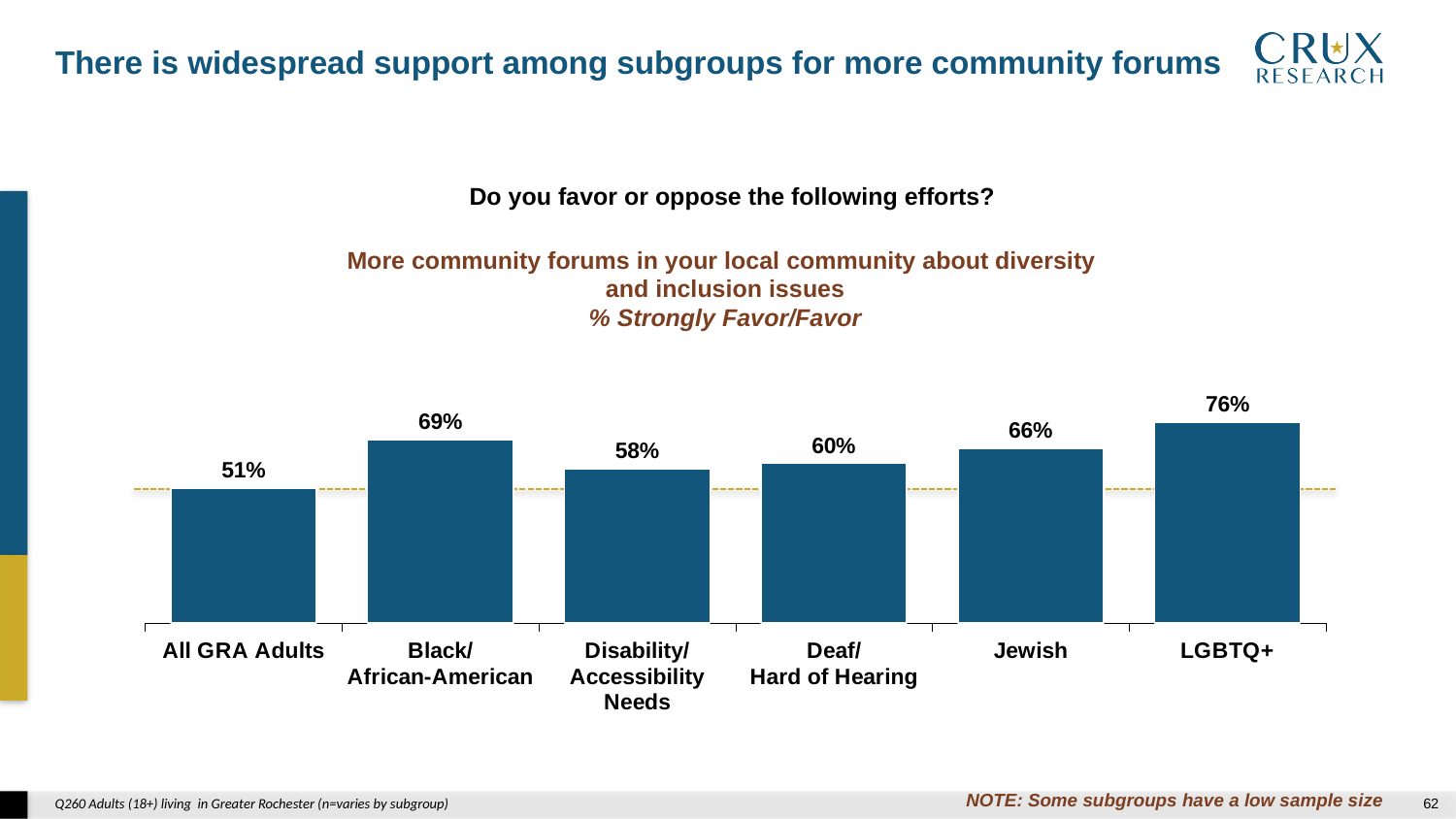
What kind of chart is shown on the slide? Bar chart Which category has the lowest percentage shown on the chart? All GRA Adults What percentage of All GRA Adults strongly favor or favor more community forums about diversity and inclusion issues? 51% What is the difference between the Black/African-American value and the Jewish value? 3% Which is larger, the value for Disability/Accessibility Needs or the value for Deaf/Hard of Hearing? Deaf/Hard of Hearing What is the value shown for the Deaf/Hard of Hearing subgroup? 60% What is the value shown for the Black/African-American subgroup? 69% What measure does the chart subtitle say the bars represent? % Strongly Favor/Favor How many subgroups (bars) are shown on the chart? 6 What is the value shown for the Jewish subgroup? 66% Which subgroup has the highest percentage of strongly favor/favor? LGBTQ+ What is the difference between the LGBTQ+ value and the All GRA Adults value? 25%